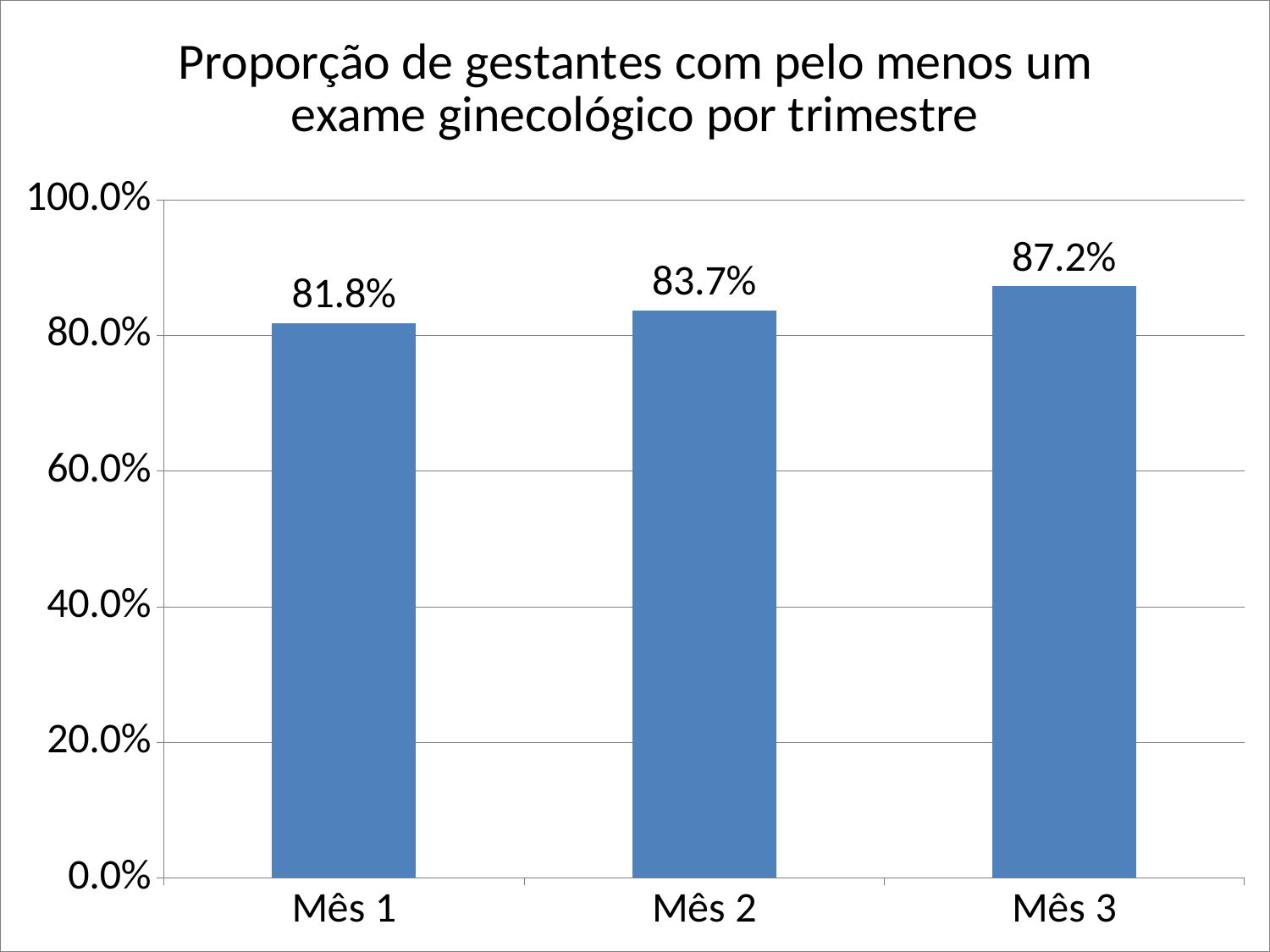
What is the value for Mês 2? 83.7% Which is larger, the value for Mês 2 or the value for Mês 3? Mês 3 What is the value for Mês 1? 81.8% Which month has the highest value? Mês 3 Is the value for Mês 1 greater or less than 80.0%? greater What is the difference between the values for Mês 3 and Mês 1? 5.4% What kind of chart is this? bar chart Do the values rise or fall from Mês 1 to Mês 3? rise How many months are shown on the x axis? 3 What is the difference between the values for Mês 2 and Mês 1? 1.9% Which month has the lowest value? Mês 1 What is the value for Mês 3? 87.2%